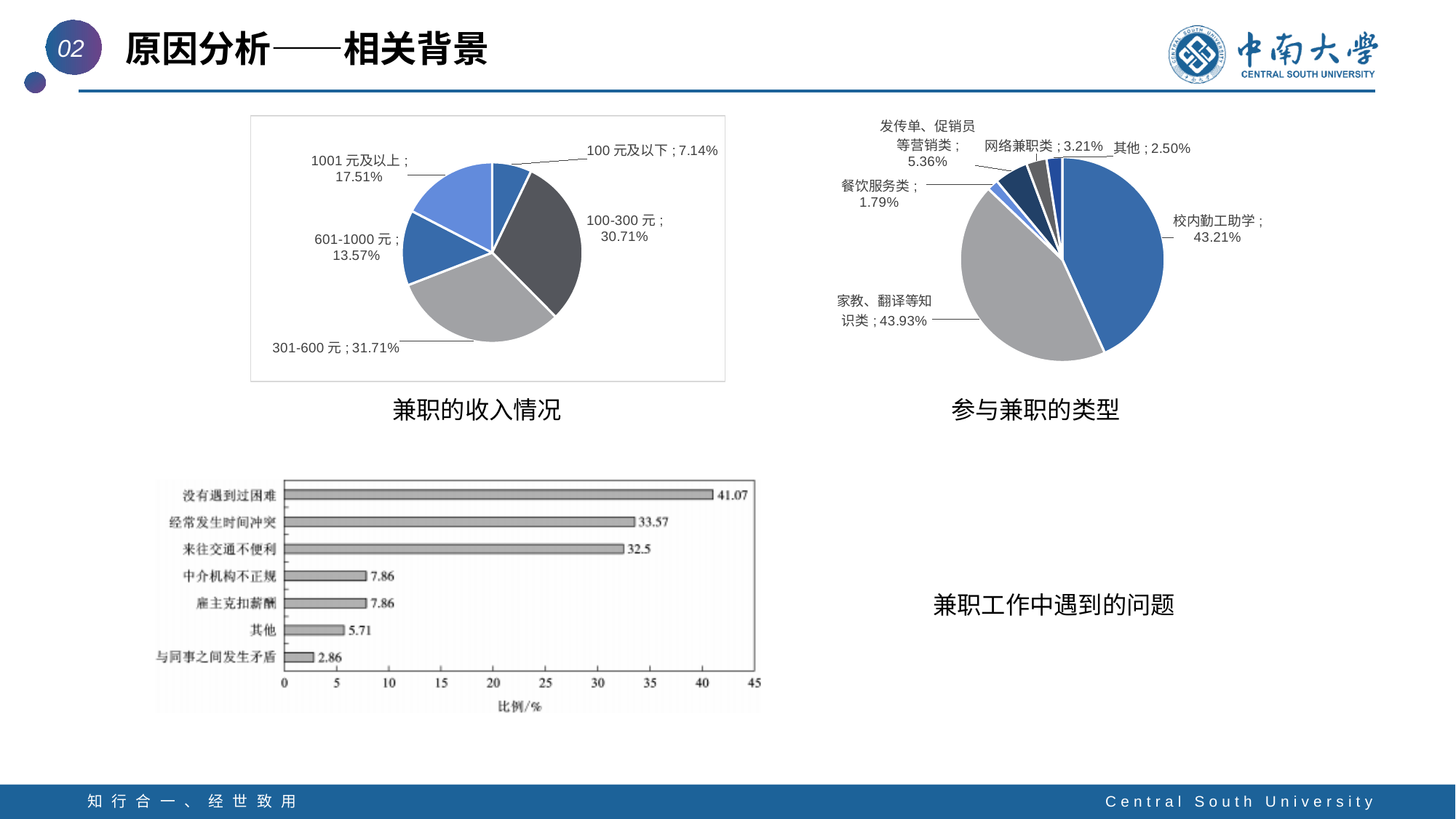
In the chart titled 兼职的收入情况, which category has the smallest share? 100 元及以下 In the chart titled 兼职工作中遇到的问题, what kind of chart is shown? bar chart In the chart titled 参与兼职的类型, which is larger: 网络兼职类 or 其他? 网络兼职类 In the chart titled 兼职的收入情况, what share is labelled for 301-600 元? 31.71% In the chart titled 参与兼职的类型, what kind of chart is shown? pie chart In the chart titled 兼职的收入情况, what is the difference between the shares for 1001 元及以上 and 601-1000 元? 3.94% In the chart titled 兼职工作中遇到的问题, which category has the highest value? 没有遇到过困难 In the chart titled 参与兼职的类型, what share is labelled for 校内勤工助学? 43.21% In the chart titled 参与兼职的类型, which category has the largest share? 家教、翻译等知识类 In the chart titled 兼职工作中遇到的问题, what is the value for 经常发生时间冲突? 33.57 In the chart titled 兼职工作中遇到的问题, what is the difference between 来往交通不便利 and 与同事之间发生矛盾? 29.64 In the chart titled 兼职的收入情况, how many slices does the pie have? 5